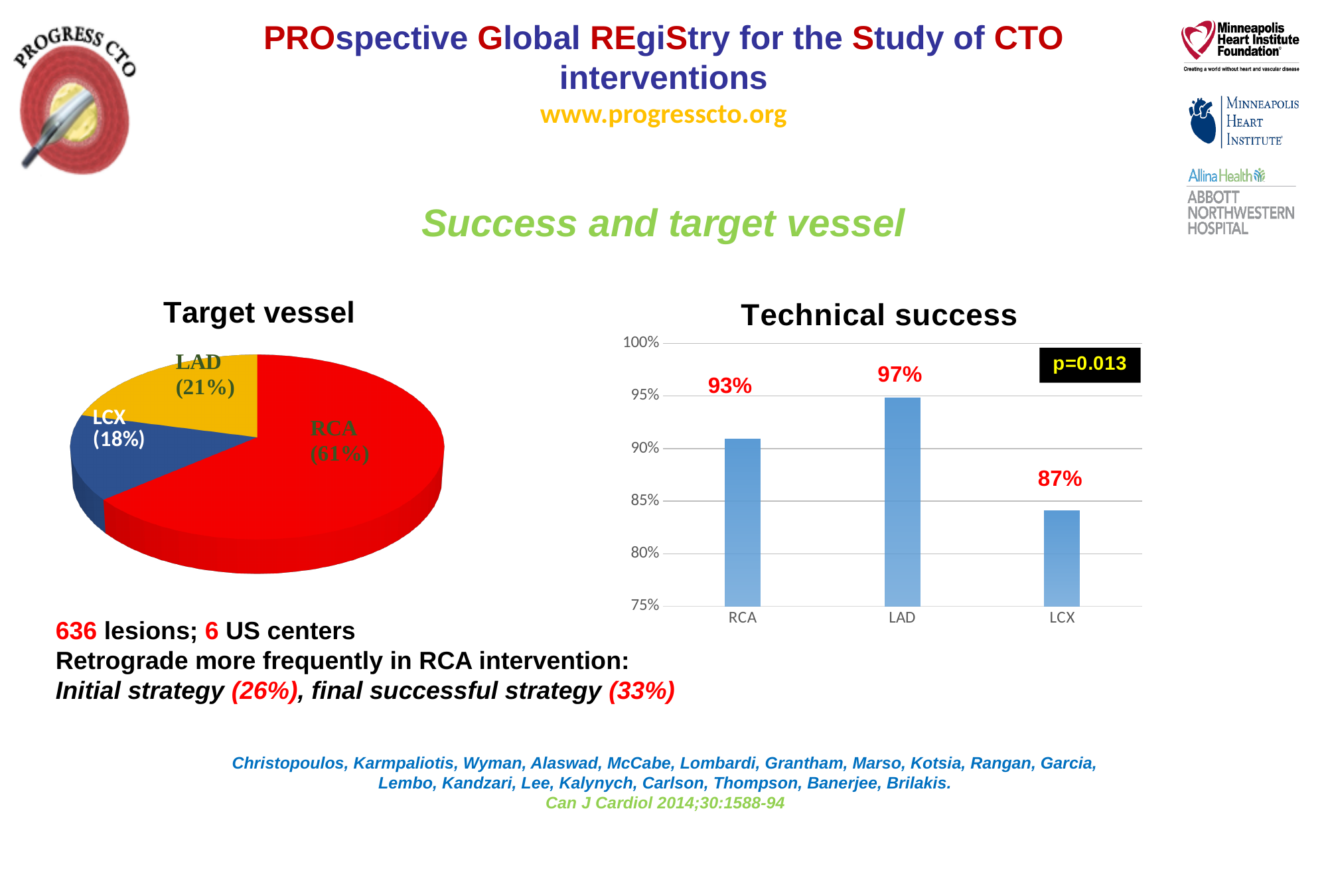
In the Technical success chart, what is the value for LAD? 97% In the Technical success chart, what is the value for LCX? 87% In the Technical success chart, which vessel has the lowest technical success? LCX In the Technical success chart, is the value for LCX greater or less than 90%? less In the Target vessel pie chart, what share is RCA? 61% In the Target vessel pie chart, what share is LCX? 18% In the Target vessel pie chart, which vessel has the largest slice? RCA In the Technical success chart, what is the difference between the LAD and LCX values? 10% What kind of chart is the Target vessel chart? Pie chart In the Target vessel pie chart, how many slices are there? 3 What kind of chart is the Technical success chart? Bar chart In the Target vessel pie chart, which vessel has the smallest slice? LCX